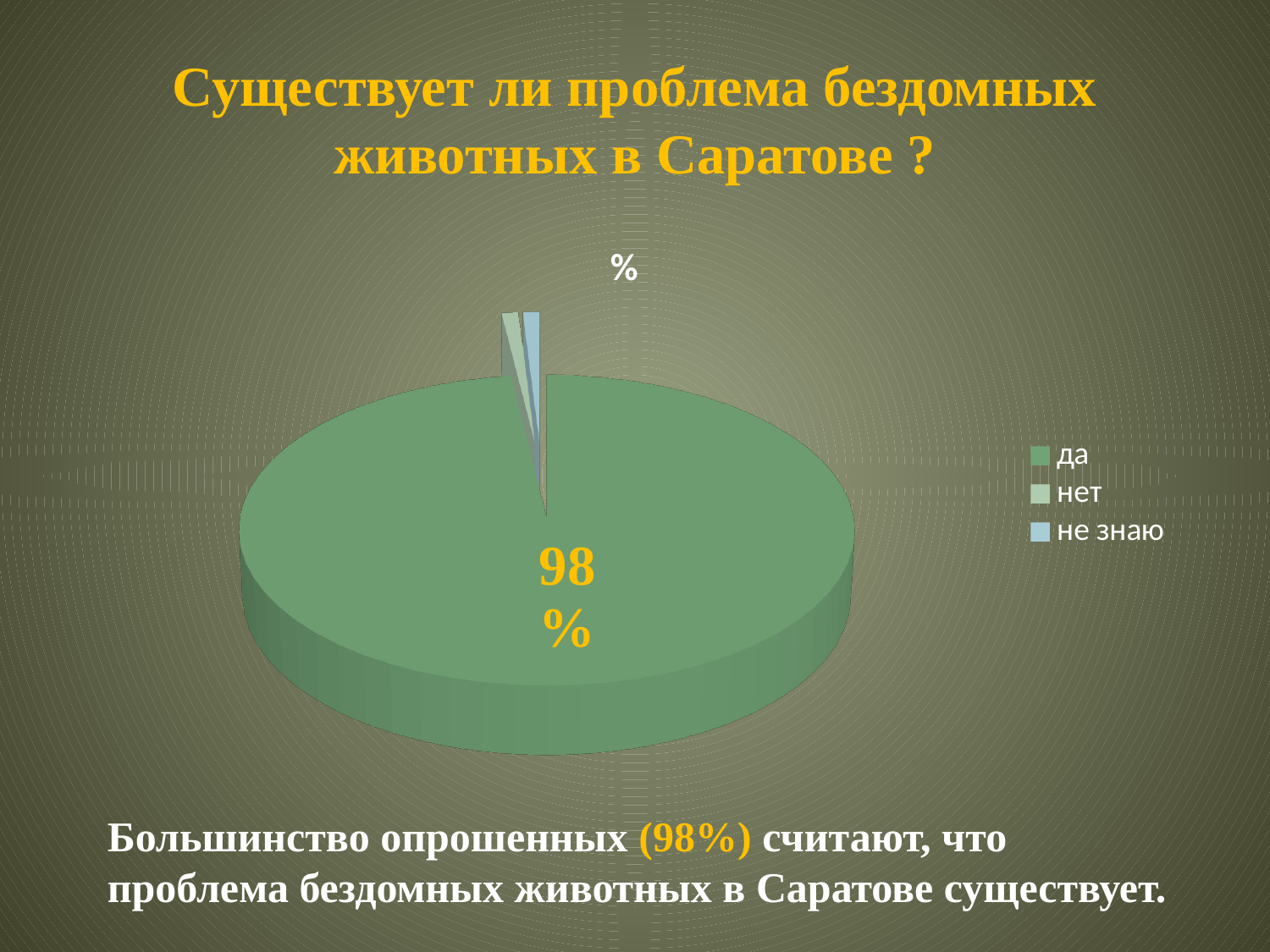
What share of the pie does the "да" slice take? 98% Which slice is larger in the pie chart, "да" or "нет"? да What kind of chart is shown on the slide? pie chart Which slice is larger in the pie chart, "да" or "не знаю"? да What are the three legend entries of the pie chart? да, нет, не знаю What colour is the "да" slice in the pie chart? green What percentage of respondents answered "да" according to the pie chart? 98% Which category has the largest slice in the pie chart? да How many categories does the legend of the pie chart list? 3